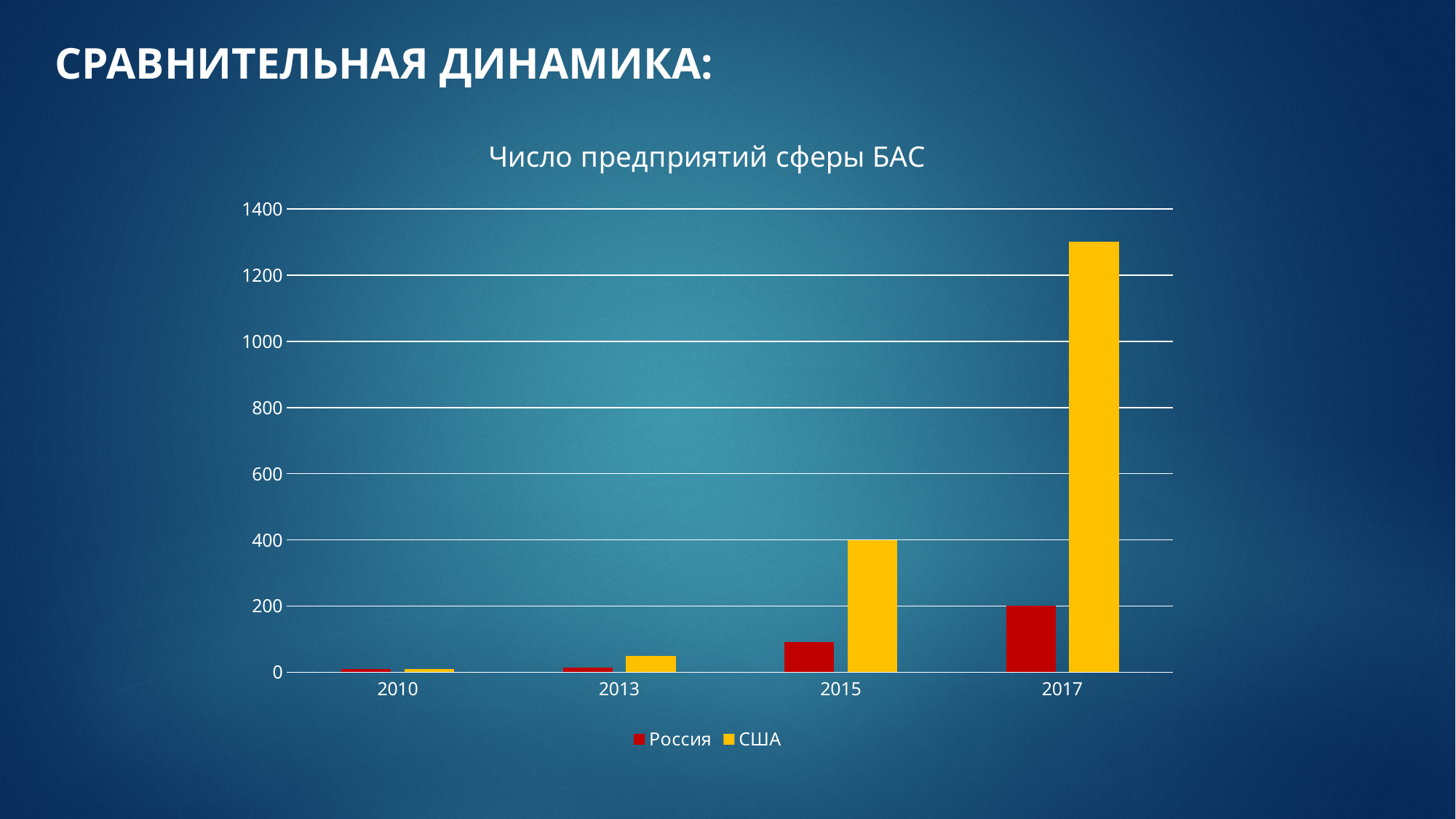
How many years are shown on the x axis? 4 What type of chart is shown on the slide? bar chart Which year has the highest value for США? 2017 Is the value for Россия in 2015 greater or less than 200? less Is the value for США in 2013 greater or less than 200? less Which year has the lowest value for США? 2010 Do the values for США rise or fall from 2010 to 2017? rise How many series does the legend list? 2 Is the value for США in 2017 greater or less than 1200? greater Which series is shown in red? Россия What is the title of the chart? Число предприятий сферы БАС In 2017, which series has the larger value, Россия or США? США